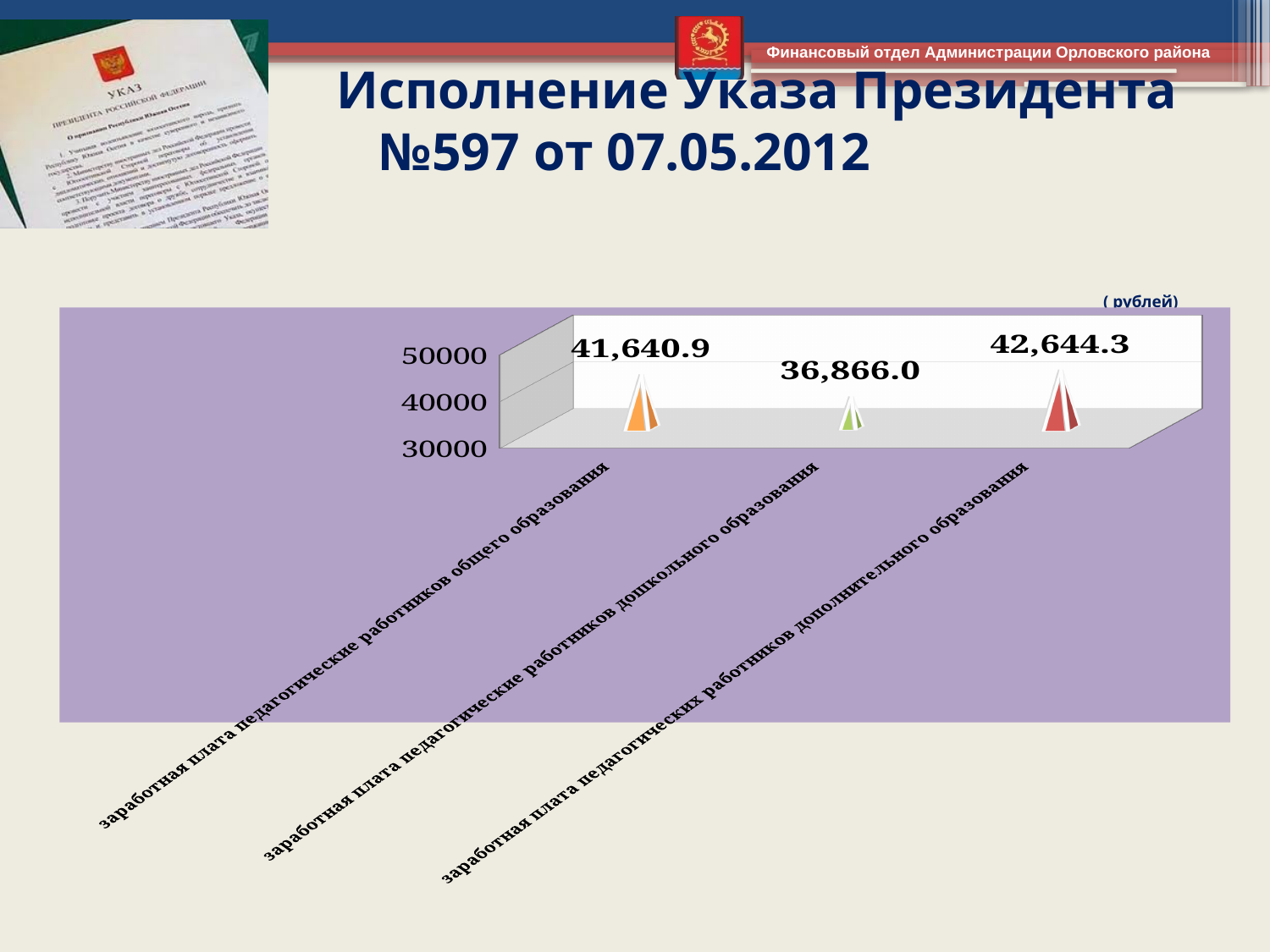
Is the value for дошкольного образования greater or less than 40000? less How many categories are shown in the chart? 3 What is the value for заработная плата педагогических работников общего образования? 41,640.9 What is the value for заработная плата педагогических работников дополнительного образования? 42,644.3 What is the value for заработная плата педагогических работников дошкольного образования? 36,866.0 Which category has the highest value? заработная плата педагогических работников дополнительного образования What unit is indicated for the chart values? рублей What is the highest value shown on the vertical axis? 50000 What is the difference between the values for дополнительного образования and общего образования? 1,003.4 Which is larger: the value for общего образования or the value for дошкольного образования? общего образования What is the difference between the values for общего образования and дошкольного образования? 4,774.9 Which category has the lowest value? заработная плата педагогических работников дошкольного образования